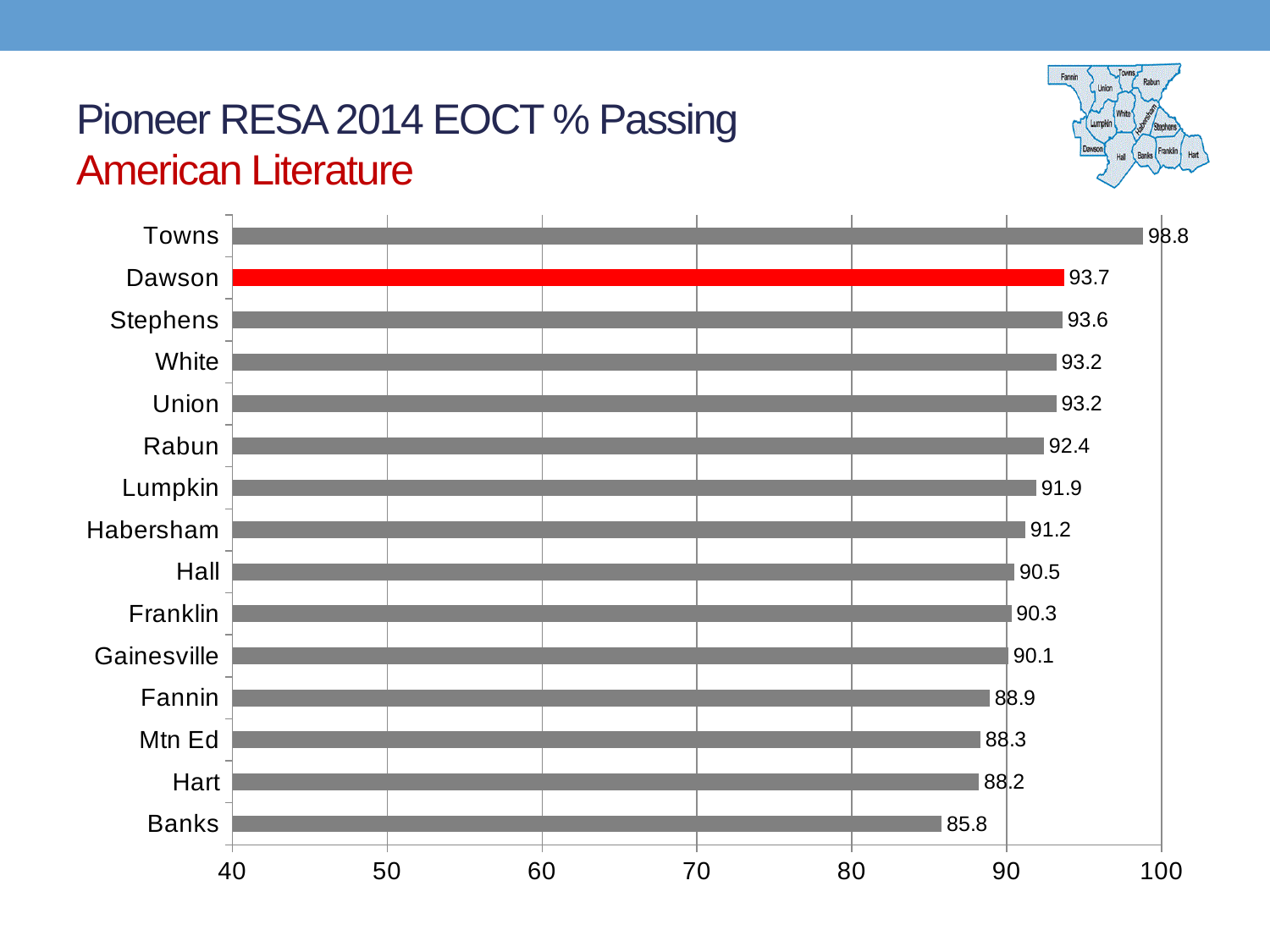
What is the % passing value for Habersham? 91.2 Which has a higher % passing, Rabun or Fannin? Rabun Is the value for Mtn Ed greater or less than 90? less What is the difference between the values for Towns and Dawson? 5.1 What is the % passing value for Dawson? 93.7 Which district has the highest % passing? Towns What kind of chart is shown on the slide? bar chart What is the % passing value for Banks? 85.8 What is the difference between the values for Hall and Banks? 4.7 How many districts are shown in the chart? 15 Which district has the lowest % passing? Banks Which district's bar is highlighted in red? Dawson